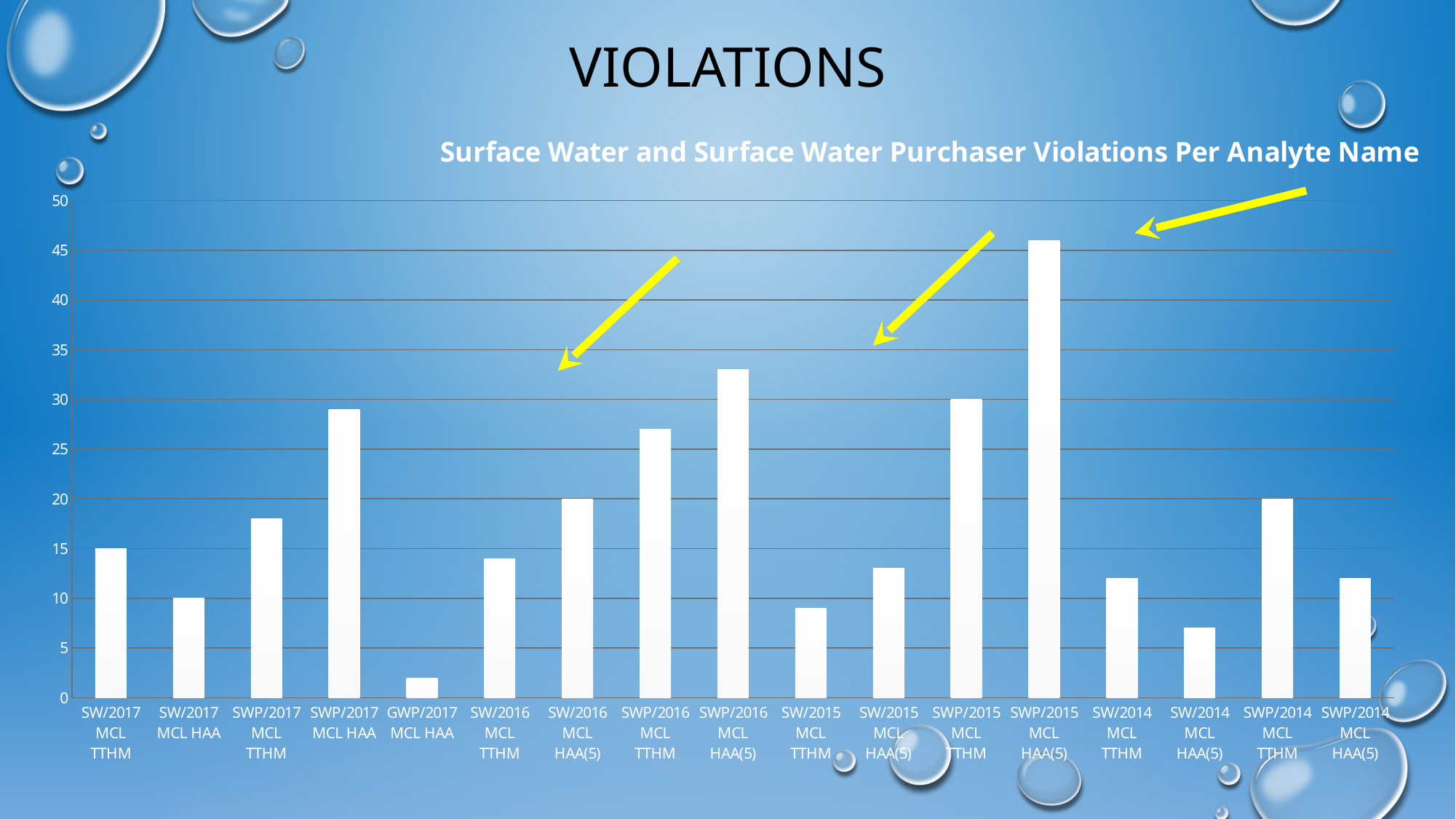
What is the value for SW/2017 MCL HAA? 10 What is the value for SWP/2014 MCL TTHM? 20 Is the value for SWP/2015 MCL HAA(5) greater or less than 45? greater Which category has the highest number of violations? SWP/2015 MCL HAA(5) What is the value for SW/2017 MCL TTHM? 15 What is the value for SWP/2015 MCL TTHM? 30 What kind of chart is shown on the slide? bar chart Which category has the lowest number of violations? GWP/2017 MCL HAA What is the title of the chart? Surface Water and Surface Water Purchaser Violations Per Analyte Name Which is larger, the value for SWP/2016 MCL HAA(5) or the value for SWP/2017 MCL HAA? SWP/2016 MCL HAA(5) Is the value for SW/2014 MCL HAA(5) greater or less than 10? less How many categories are plotted on the x axis? 17